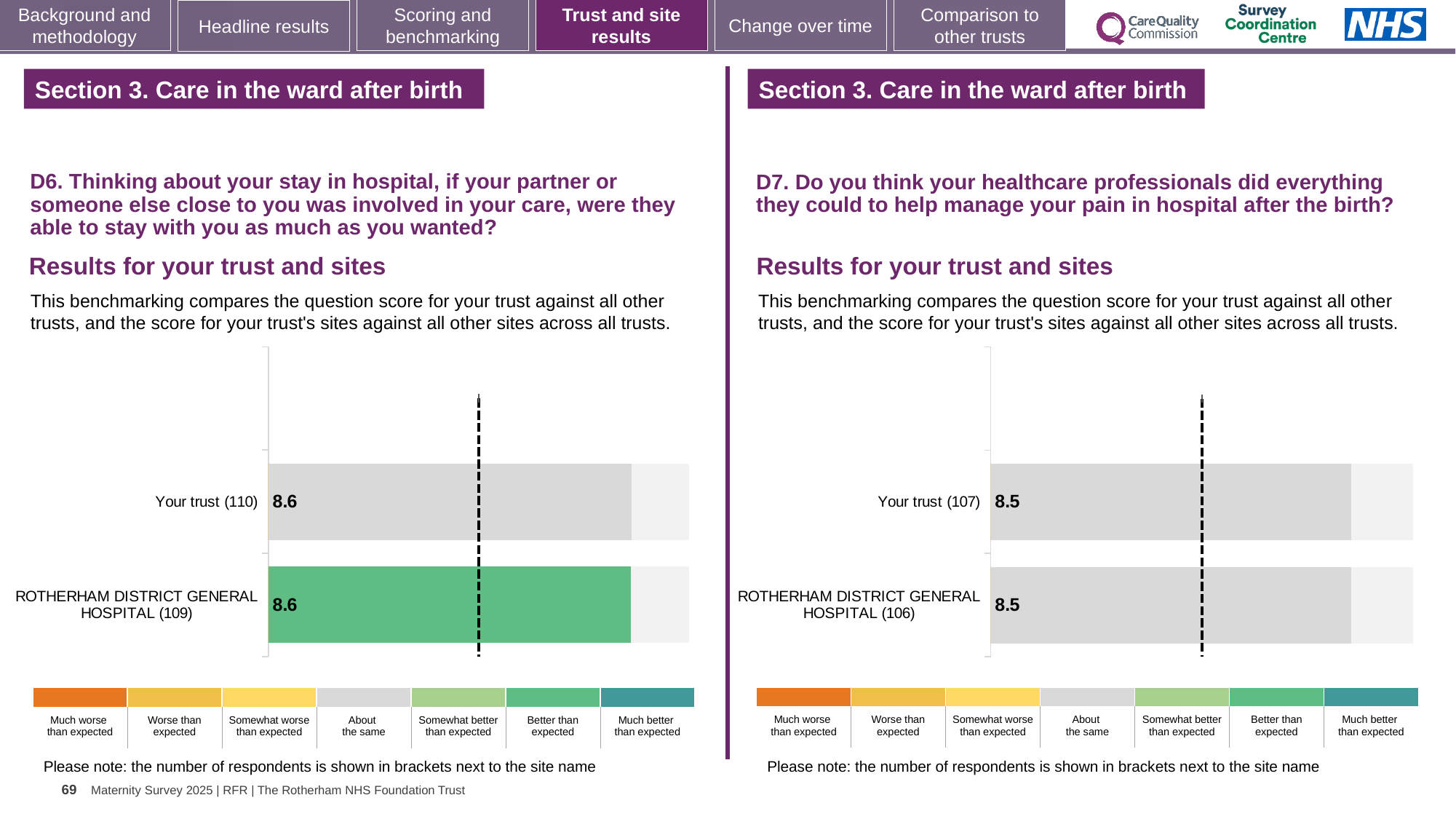
On the D7 chart (right), which benchmark category does the grey colour of the Your trust bar correspond to in the legend? About the same How many bars are plotted on the D6 chart (left)? 2 On the D6 chart (left), what is the score for ROTHERHAM DISTRICT GENERAL HOSPITAL (109)? 8.6 On the D7 chart (right), what is the difference between the score for Your trust and the score for ROTHERHAM DISTRICT GENERAL HOSPITAL? 0.0 On the D6 chart (left), which benchmark category does the green colour of the ROTHERHAM DISTRICT GENERAL HOSPITAL bar correspond to in the legend? Better than expected On the D7 chart (right), what is the score for Your trust (107)? 8.5 On the D6 chart (left), what is the difference between the score for Your trust and the score for ROTHERHAM DISTRICT GENERAL HOSPITAL? 0.0 On the D7 chart (right), what is the score for ROTHERHAM DISTRICT GENERAL HOSPITAL (106)? 8.5 How many bars are plotted on the D7 chart (right)? 2 On the D6 chart (left), what is the score for Your trust (110)? 8.6 What kind of chart is used on the D6 chart (left)? Bar chart How many respondents are shown in brackets for Your trust on the D7 chart (right)? 107